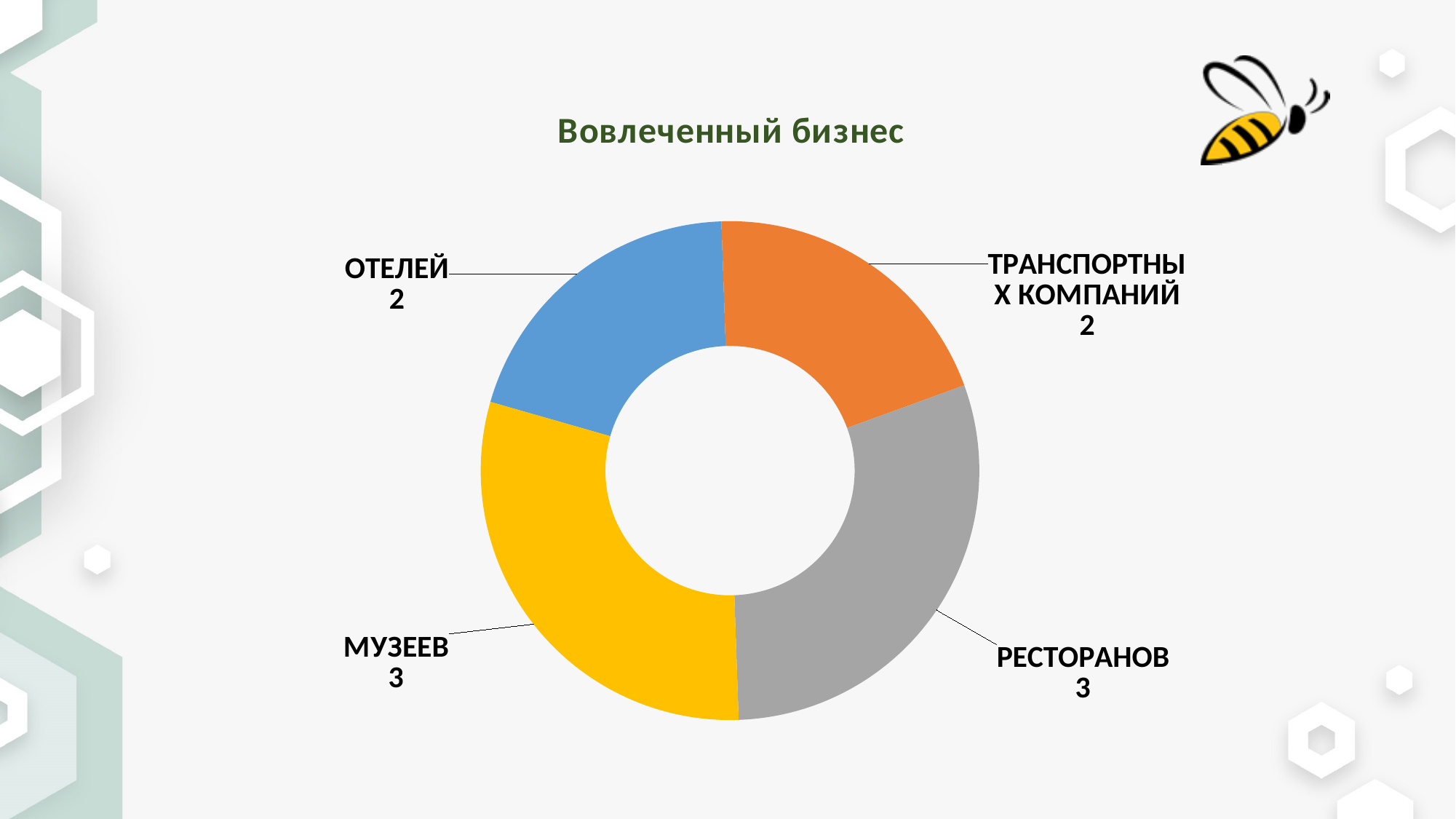
What is the value for РЕСТОРАНОВ? 3 What share of the total does РЕСТОРАНОВ represent? 30% What colour is the МУЗЕЕВ segment? Yellow Which is larger, the value for МУЗЕЕВ or the value for ТРАНСПОРТНЫХ КОМПАНИЙ? МУЗЕЕВ What is the value for ОТЕЛЕЙ? 2 What kind of chart is shown on the slide? Doughnut chart What is the value for МУЗЕЕВ? 3 What is the difference between the values for РЕСТОРАНОВ and ОТЕЛЕЙ? 1 What is the title of the chart? Вовлеченный бизнес What share of the total does ОТЕЛЕЙ represent? 20% How many categories does the chart show? 4 What is the value for ТРАНСПОРТНЫХ КОМПАНИЙ? 2